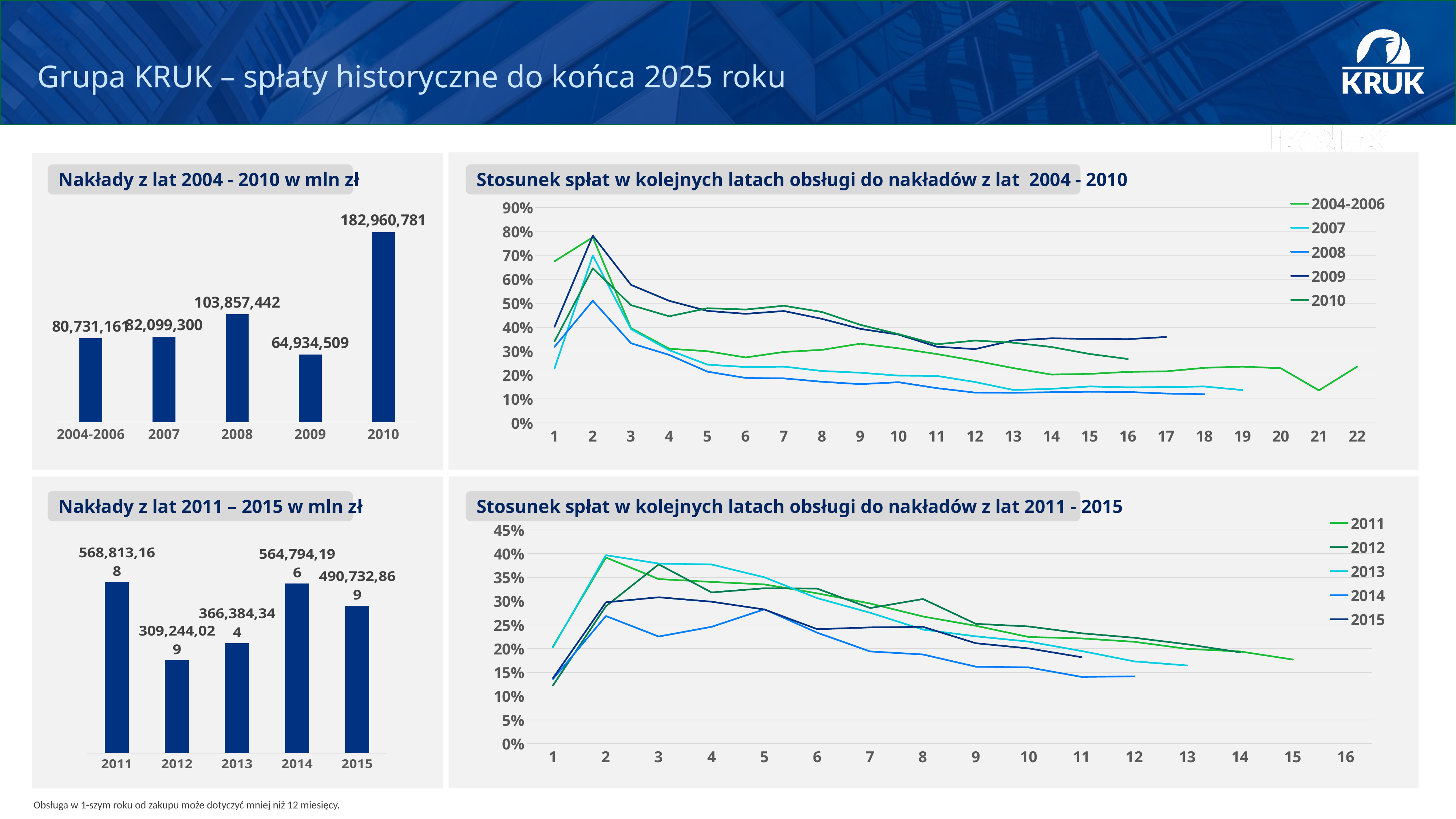
In the chart 'Nakłady z lat 2004 - 2010 w mln zł', what is the difference between the values for 2010 and 2009? 118,026,272 In the chart 'Nakłady z lat 2011 – 2015 w mln zł', which category has the lowest value? 2012 How many bars are in the chart 'Nakłady z lat 2011 – 2015 w mln zł'? 5 In the chart 'Stosunek spłat w kolejnych latach obsługi do nakładów z lat 2011 - 2015', does the 2014 line rise or fall from year 5 to year 11? fall How many series does the legend list in the chart 'Stosunek spłat w kolejnych latach obsługi do nakładów z lat 2004 - 2010'? 5 What kind of chart is 'Nakłady z lat 2004 - 2010 w mln zł'? bar chart In the chart 'Nakłady z lat 2004 - 2010 w mln zł', what is the value for 2010? 182,960,781 In the chart 'Nakłady z lat 2011 – 2015 w mln zł', what is the value for 2012? 309,244,029 In the chart 'Nakłady z lat 2004 - 2010 w mln zł', what is the value for 2009? 64,934,509 In the chart 'Nakłady z lat 2004 - 2010 w mln zł', which category has the lowest value? 2009 In the chart 'Nakłady z lat 2004 - 2010 w mln zł', which category has the highest value? 2010 In the chart 'Stosunek spłat w kolejnych latach obsługi do nakładów z lat 2004 - 2010', is the value of the 2009 series at year 2 greater or less than 70%? greater